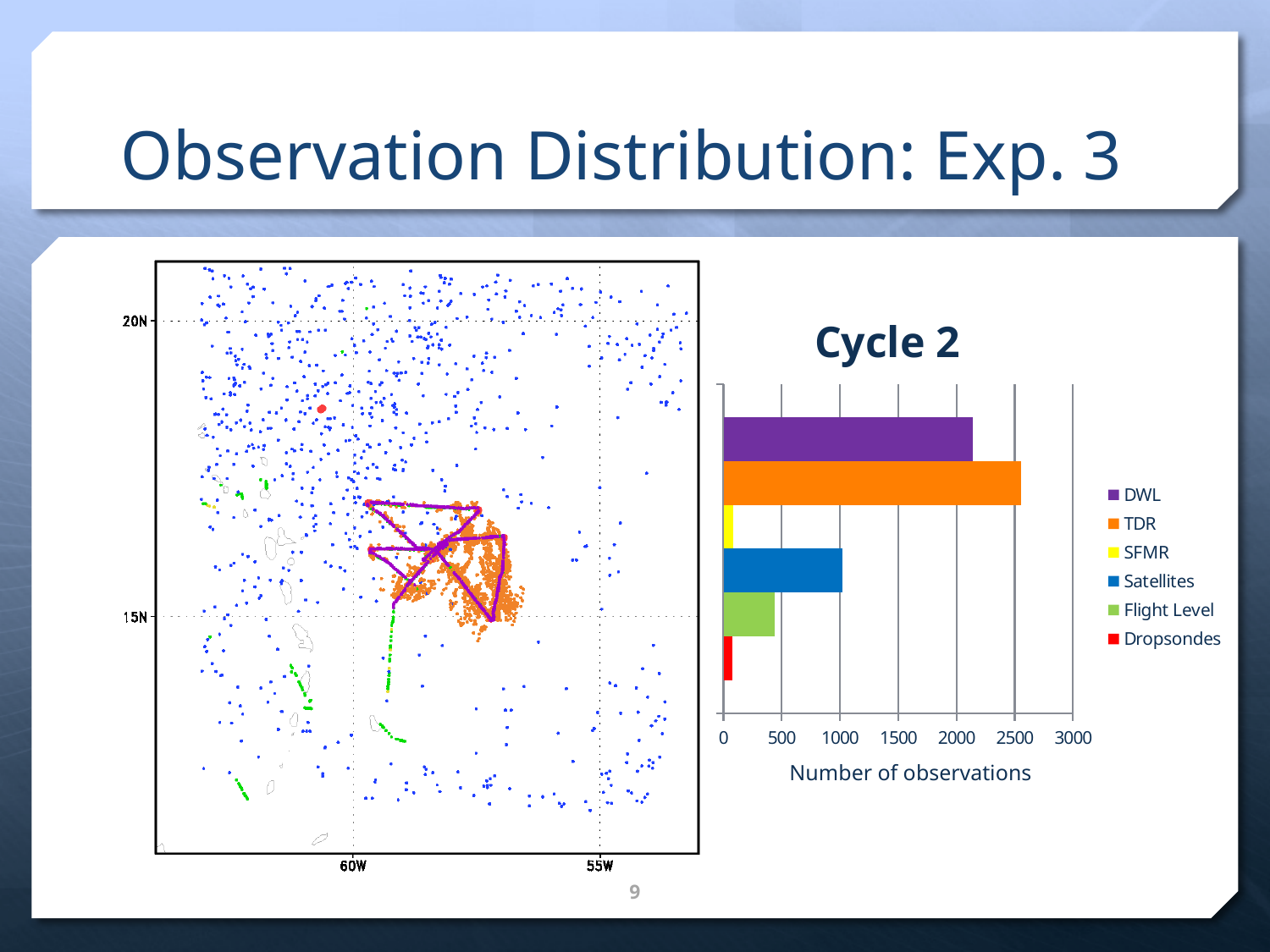
On the Cycle 2 chart, how many bars are plotted? 6 On the Cycle 2 chart, which observation type has the highest number of observations? TDR On the Cycle 2 chart, what kind of chart is shown? bar chart On the Cycle 2 chart, is the value for DWL greater or less than 2000? greater On the Cycle 2 chart, which is larger, the number of observations for Satellites or for Flight Level? Satellites On the Cycle 2 chart, which is larger, the number of observations for DWL or for TDR? TDR On the Cycle 2 chart, is the value for Satellites greater or less than 500? greater On the Cycle 2 chart, is the value for TDR greater or less than 2000? greater On the Cycle 2 chart, how many series does the legend list? 6 On the Cycle 2 chart, what is the label of the horizontal axis? Number of observations